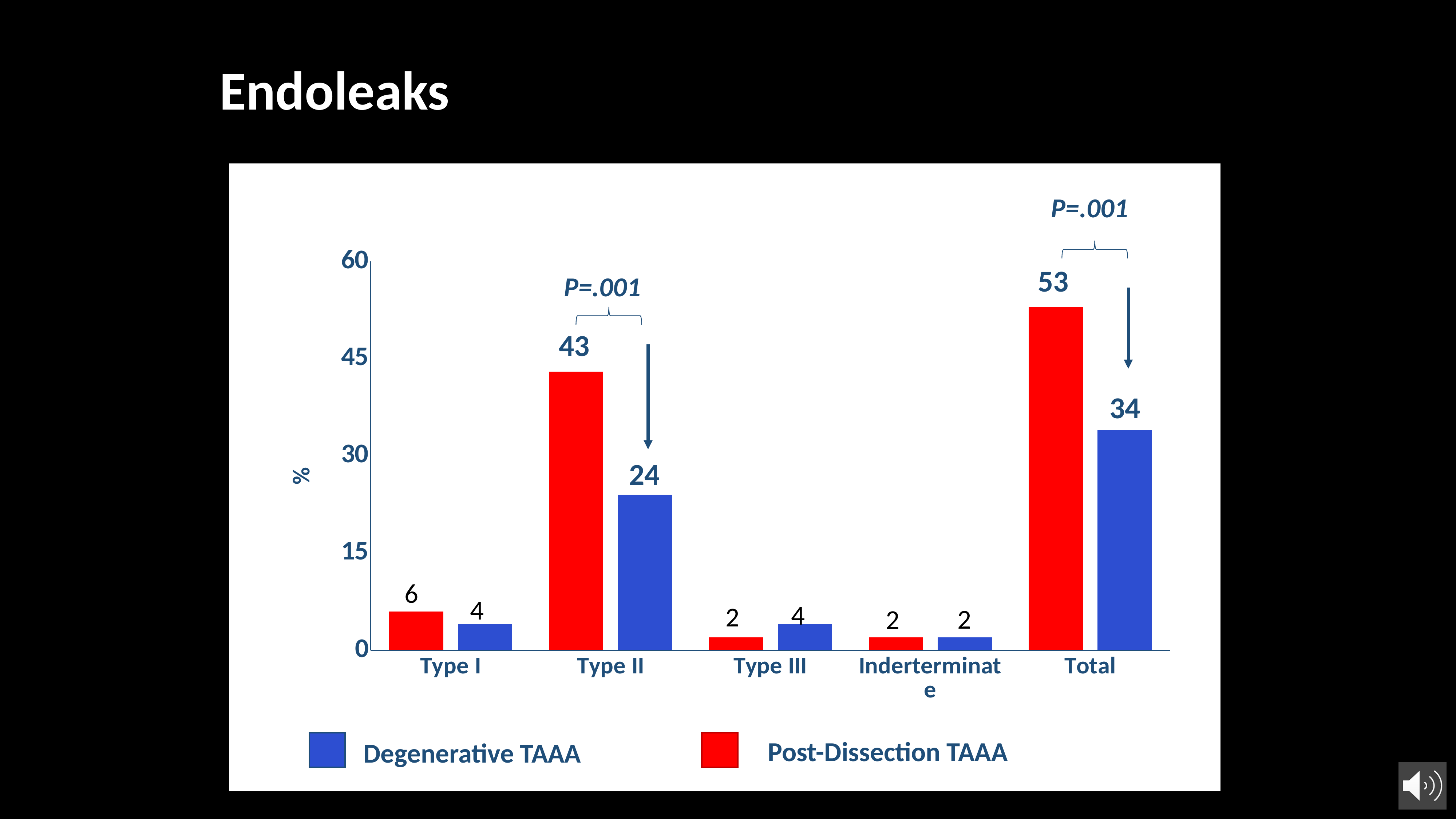
How many series does the legend list? 2 What is the Degenerative TAAA value for Type I? 4 Which category has the lowest Degenerative TAAA value? Inderterminate How many categories are shown on the x axis? 5 For Type III, which series has the larger value, Degenerative TAAA or Post-Dissection TAAA? Degenerative TAAA What is the difference between the Post-Dissection TAAA and Degenerative TAAA values for Total? 19 What is the Degenerative TAAA value for Total? 34 What kind of chart is shown on the slide? bar chart What is the Post-Dissection TAAA value for Type II? 43 What is the difference between the Post-Dissection TAAA and Degenerative TAAA values for Type II? 19 Is the Post-Dissection TAAA value for Total greater or less than 45? greater Which category has the highest Post-Dissection TAAA value? Total